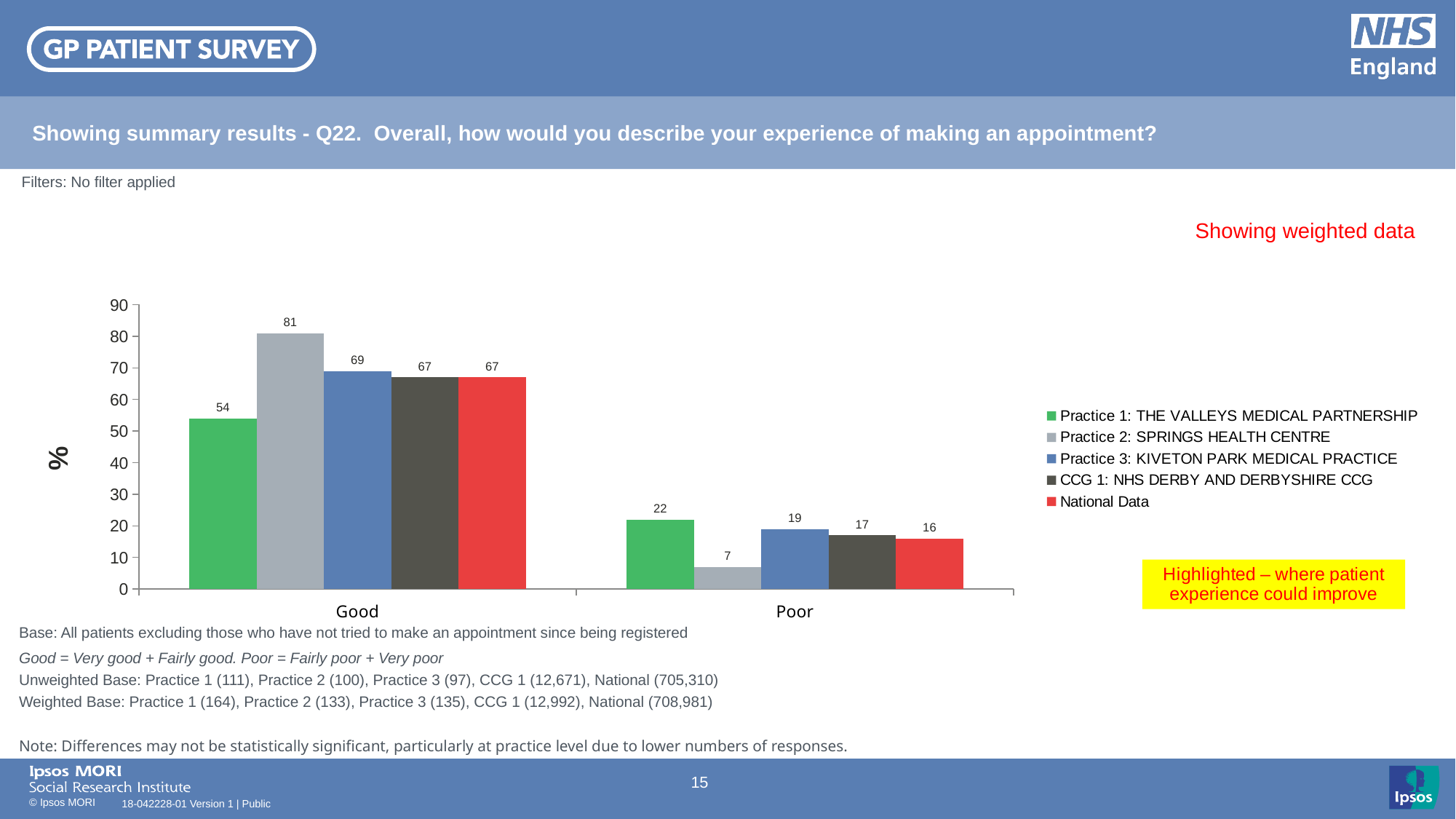
What kind of chart is shown on the slide? Bar chart Which series has the lowest value in the Poor category? Practice 2: SPRINGS HEALTH CENTRE What is the value for National Data in the Poor category? 16 What is the value for Practice 1: THE VALLEYS MEDICAL PARTNERSHIP in the Good category? 54 How many categories are shown on the x axis? 2 Which is larger in the Poor category: Practice 1 or Practice 3? Practice 1 How many series does the legend list? 5 What is the difference between Practice 2 and Practice 1 in the Good category? 27 What is the value for Practice 2: SPRINGS HEALTH CENTRE in the Good category? 81 Which series has the highest value in the Good category? Practice 2: SPRINGS HEALTH CENTRE What is the value for CCG 1: NHS DERBY AND DERBYSHIRE CCG in the Poor category? 17 What colour represents National Data in the chart? Red